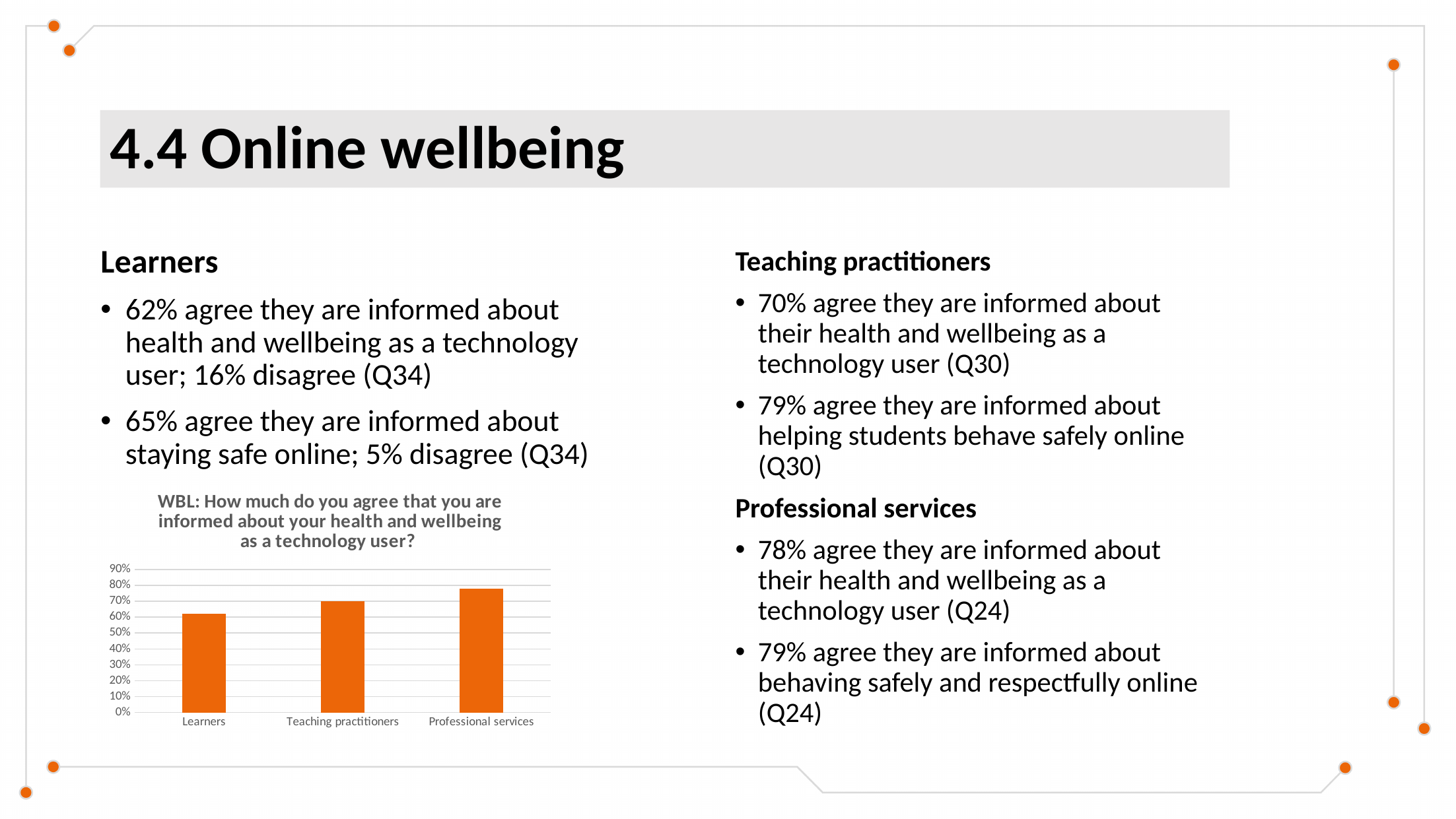
Which category has the highest bar in the chart? Professional services What is the value for Teaching practitioners in the chart? 70% What type of chart is shown on the slide? bar chart Which is larger, the value for Teaching practitioners or the value for Learners? Teaching practitioners Is the value for Learners greater or less than 60%? greater What is the title of the chart? WBL: How much do you agree that you are informed about your health and wellbeing as a technology user? What is the value for Learners in the chart? 62% Is the value for Professional services greater or less than 80%? less Which category has the lowest bar in the chart? Learners How many categories are shown on the x axis of the chart? 3 Do the bar values rise or fall from left to right across the x axis? rise What is the value for Professional services in the chart? 78%